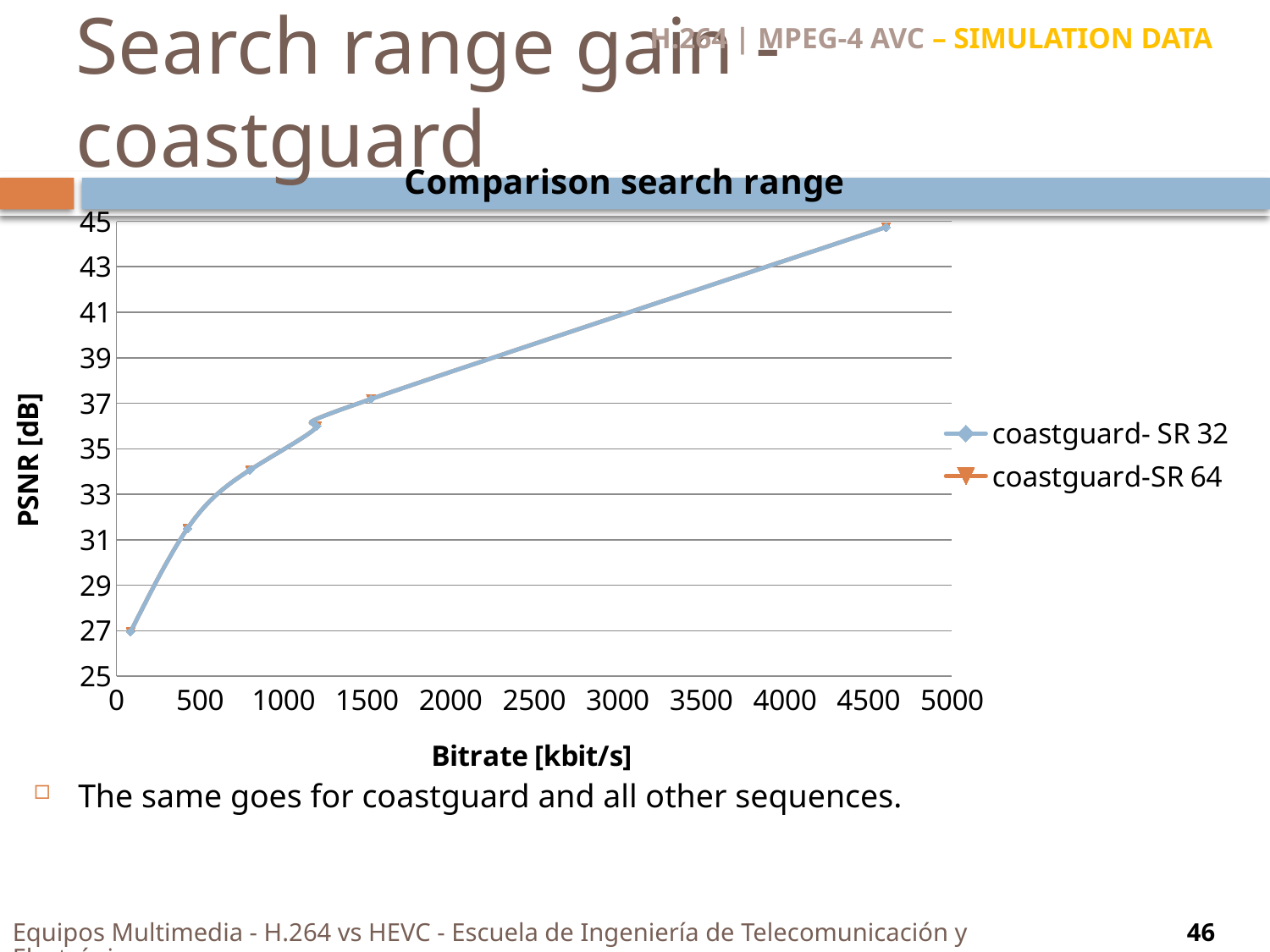
How many series does the legend list? 2 How many data points are plotted for the coastguard- SR 32 series? 6 Is the PSNR value at a bitrate of about 1500 kbit/s greater or less than 35? greater Do the PSNR values rise or fall as bitrate increases along the x axis? rise What is the title of the chart? Comparison search range What kind of chart is shown on the slide? line chart What is the label of the vertical axis? PSNR [dB] Is the PSNR value at the lowest bitrate point greater or less than 29? less Is the bitrate of the rightmost data point greater or less than 4000 kbit/s? greater What is the maximum value shown on the vertical axis? 45